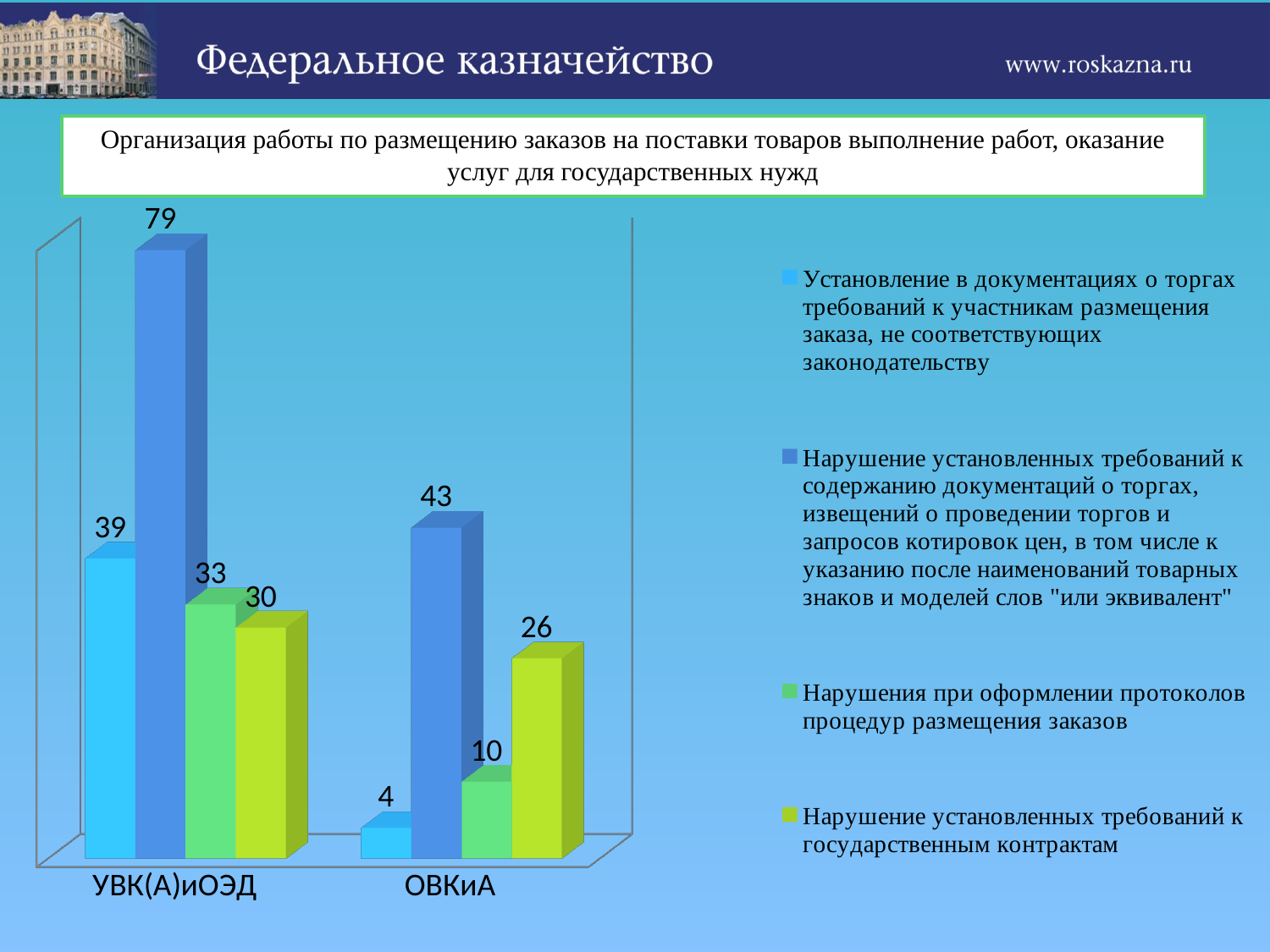
Which series has the lowest value for УВК(А)иОЭД? Нарушение установленных требований к государственным контрактам What type of chart is shown on the slide? bar chart How many categories are shown on the x axis of the chart? 2 How many series does the chart's legend list? 4 Which category has the higher value for 'Установление в документациях о торгах требований к участникам размещения заказа, не соответствующих законодательству'? УВК(А)иОЭД What is the value for 'Нарушение установленных требований к содержанию документаций о торгах...' for УВК(А)иОЭД? 79 What is the difference between the values for 'Нарушение установленных требований к содержанию документаций о торгах...' for УВК(А)иОЭД and ОВКиА? 36 Which is larger: the value for 'Нарушения при оформлении протоколов процедур размещения заказов' for УВК(А)иОЭД or for ОВКиА? УВК(А)иОЭД What is the value for 'Установление в документациях о торгах требований к участникам размещения заказа, не соответствующих законодательству' for ОВКиА? 4 What is the value for 'Нарушения при оформлении протоколов процедур размещения заказов' for УВК(А)иОЭД? 33 What is the value for 'Нарушение установленных требований к государственным контрактам' for ОВКиА? 26